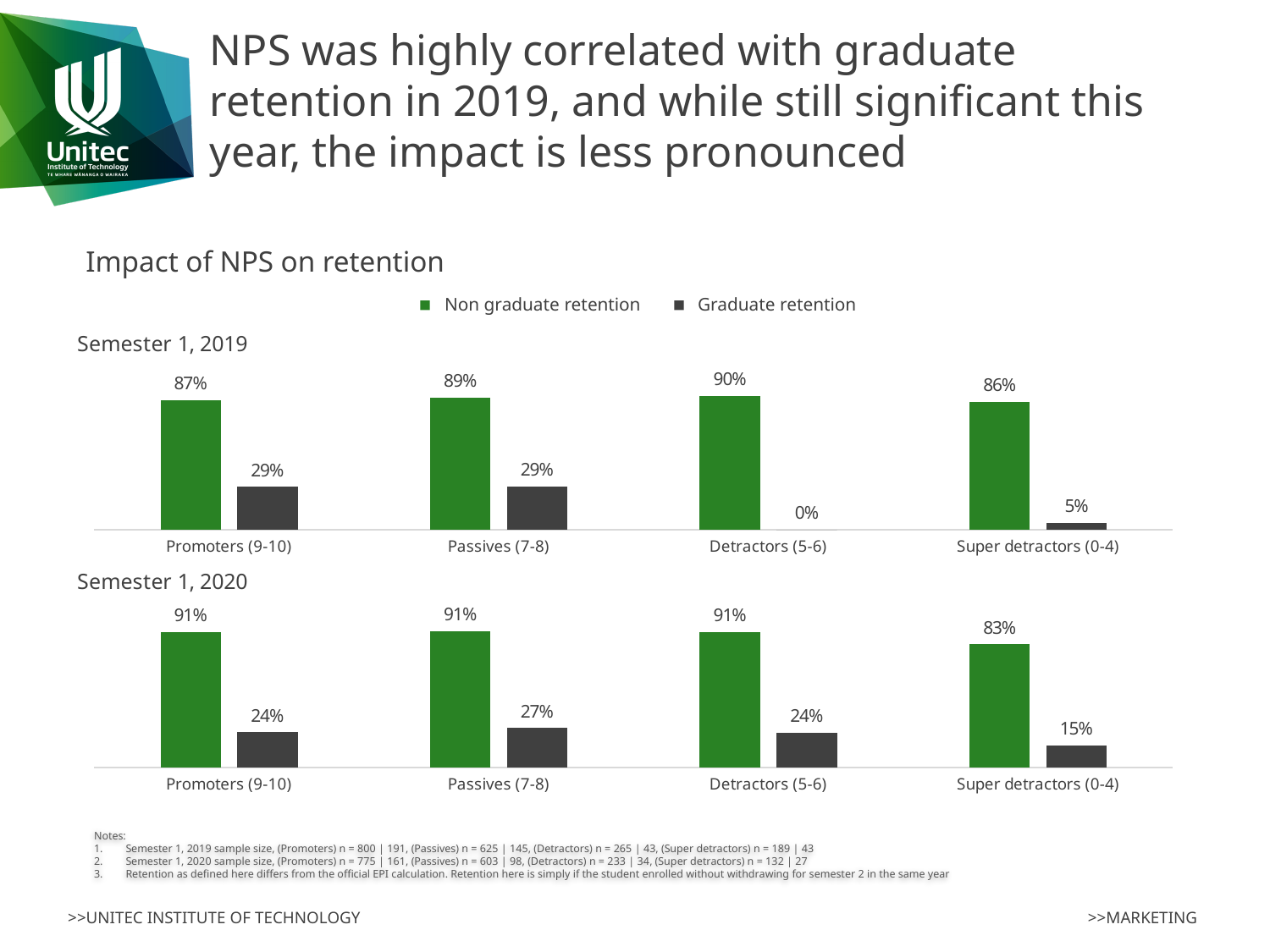
In the Semester 1, 2020 chart, which category has the lowest Graduate retention? Super detractors (0-4) In the Semester 1, 2020 chart, which is larger for Passives (7-8): Graduate retention or Non graduate retention? Non graduate retention What is the title shown above the charts? Impact of NPS on retention In the Semester 1, 2019 chart, what is the Graduate retention value for Detractors (5-6)? 0% In the Semester 1, 2020 chart, what is the Graduate retention value for Super detractors (0-4)? 15% In the Semester 1, 2020 chart, what is the Non graduate retention value for Super detractors (0-4)? 83% In the Semester 1, 2019 chart, what is the Non graduate retention value for Promoters (9-10)? 87% In the Semester 1, 2019 chart, what is the difference between Non graduate retention and Graduate retention for Promoters (9-10)? 58% In the Semester 1, 2019 chart, which category has the highest Non graduate retention? Detractors (5-6) How many series does the legend list? 2 How many categories are shown on the x axis of the Semester 1, 2020 chart? 4 What kind of chart is the Semester 1, 2019 chart? Bar chart